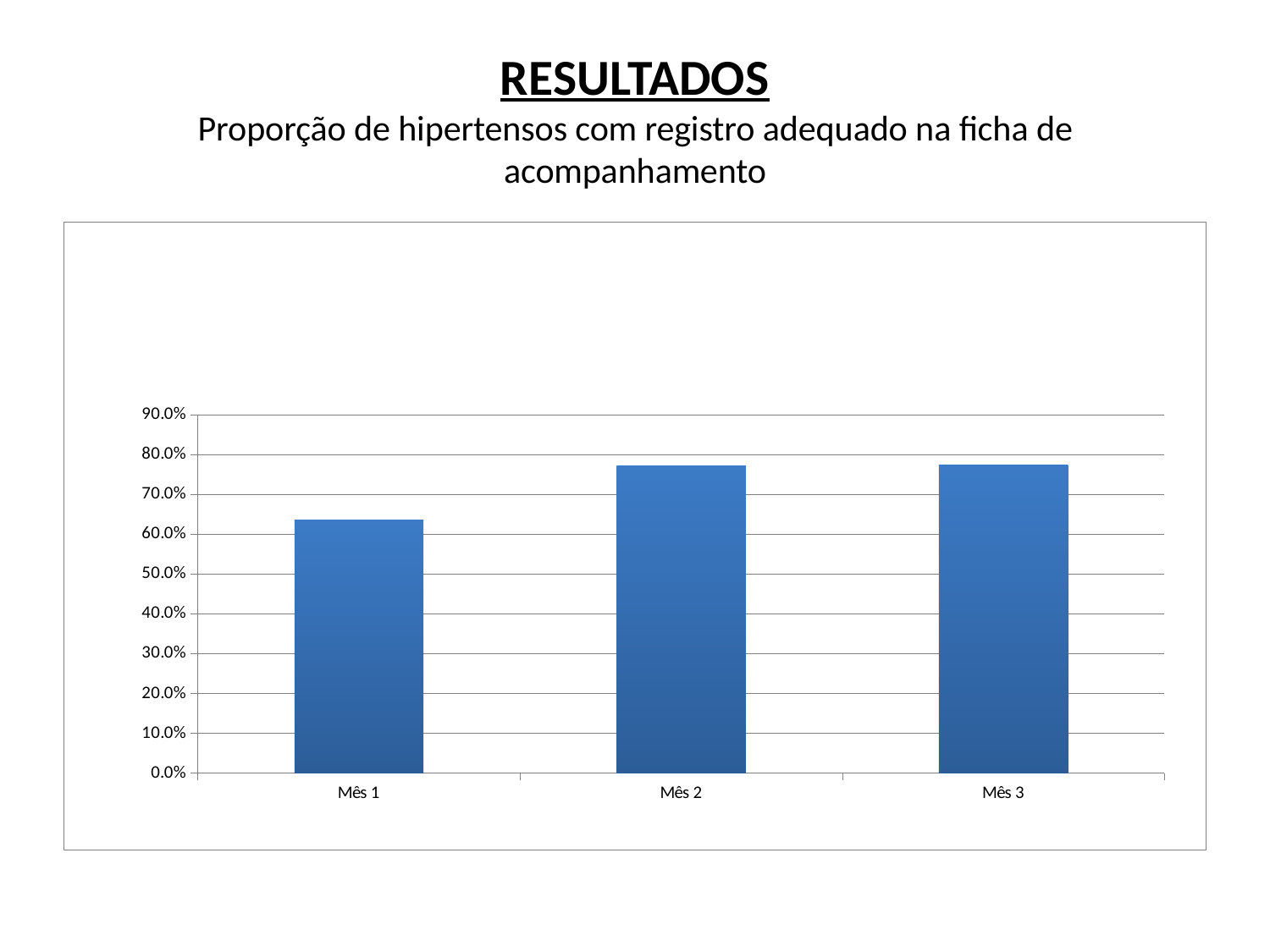
Which is larger, the value for Mês 1 or the value for Mês 3? Mês 3 Is the value for Mês 3 greater or less than 80.0%? less Is the value for Mês 2 greater or less than 80.0%? less Is the value for Mês 1 greater or less than 60.0%? greater Which is larger, the value for Mês 1 or the value for Mês 2? Mês 2 Do the values rise or fall from Mês 1 to Mês 3? rise How many categories (months) are plotted on the chart? 3 What is the highest value shown on the vertical axis of the chart? 90.0% Which month has the lowest proportion on the chart? Mês 1 What kind of chart is shown on the slide? bar chart